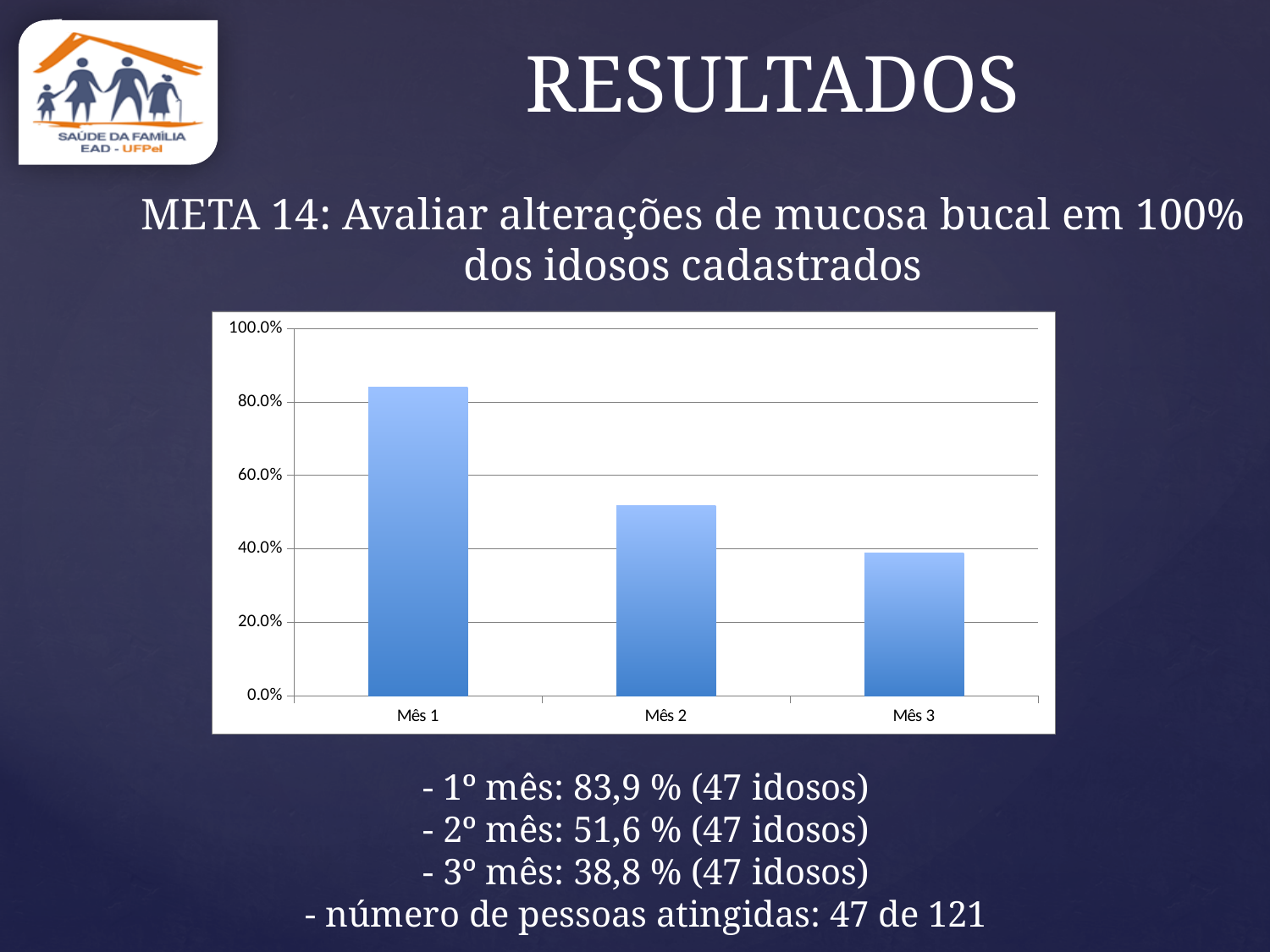
According to the text below the chart, what percentage was reached in the 1º mês? 83,9 % What kind of chart is shown on the slide? bar chart How many categories (months) are plotted on the chart? 3 What is the highest value shown on the chart's vertical axis? 100.0% Is the value for Mês 2 greater or less than 60.0%? less Do the values rise or fall from Mês 1 to Mês 3? fall Which is larger, the value for Mês 2 or the value for Mês 3? Mês 2 According to the text below the chart, what percentage was reached in the 3º mês? 38,8 % Is the value for Mês 3 greater or less than 40.0%? less Is the value for Mês 1 greater or less than 80.0%? greater Which month has the highest bar on the chart? Mês 1 Which month has the lowest bar on the chart? Mês 3